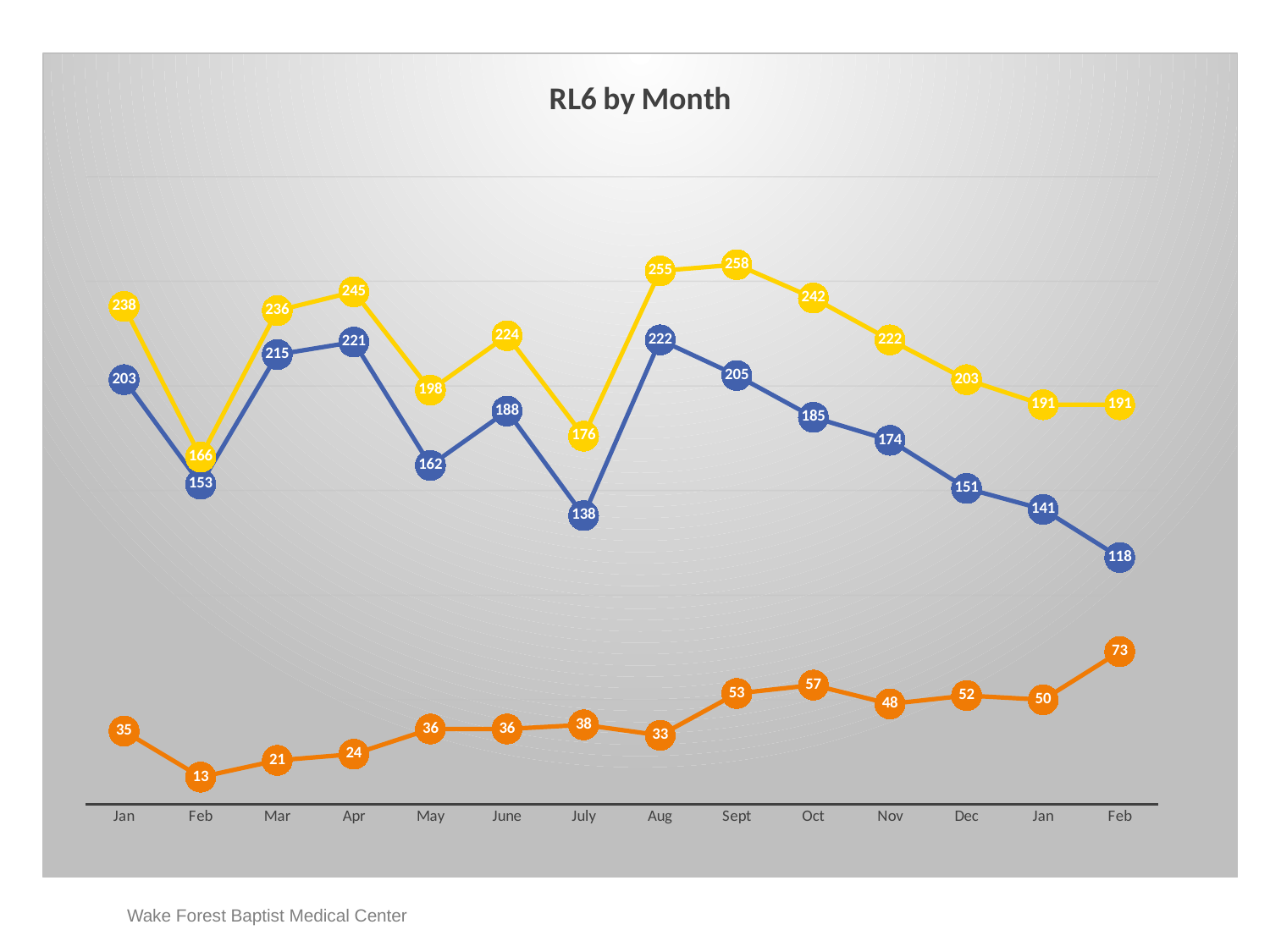
What is the value of the blue line in July? 138 In which month does the blue line reach its lowest value? the second Feb (the last month on the axis) In which month does the orange line reach its lowest value? the first Feb In which month does the yellow line reach its highest value? Sept What is the difference between the yellow line and the blue line in Aug? 33 What is the value of the yellow line in Sept? 258 What kind of chart is shown on the slide? line chart How many months are plotted along the x axis? 14 From Aug to the final Feb, does the blue line rise or fall? fall What is the value of the orange line in Oct? 57 For the blue line, which is larger: the value in Mar or the value in Apr? Apr What is the title of the chart? RL6 by Month